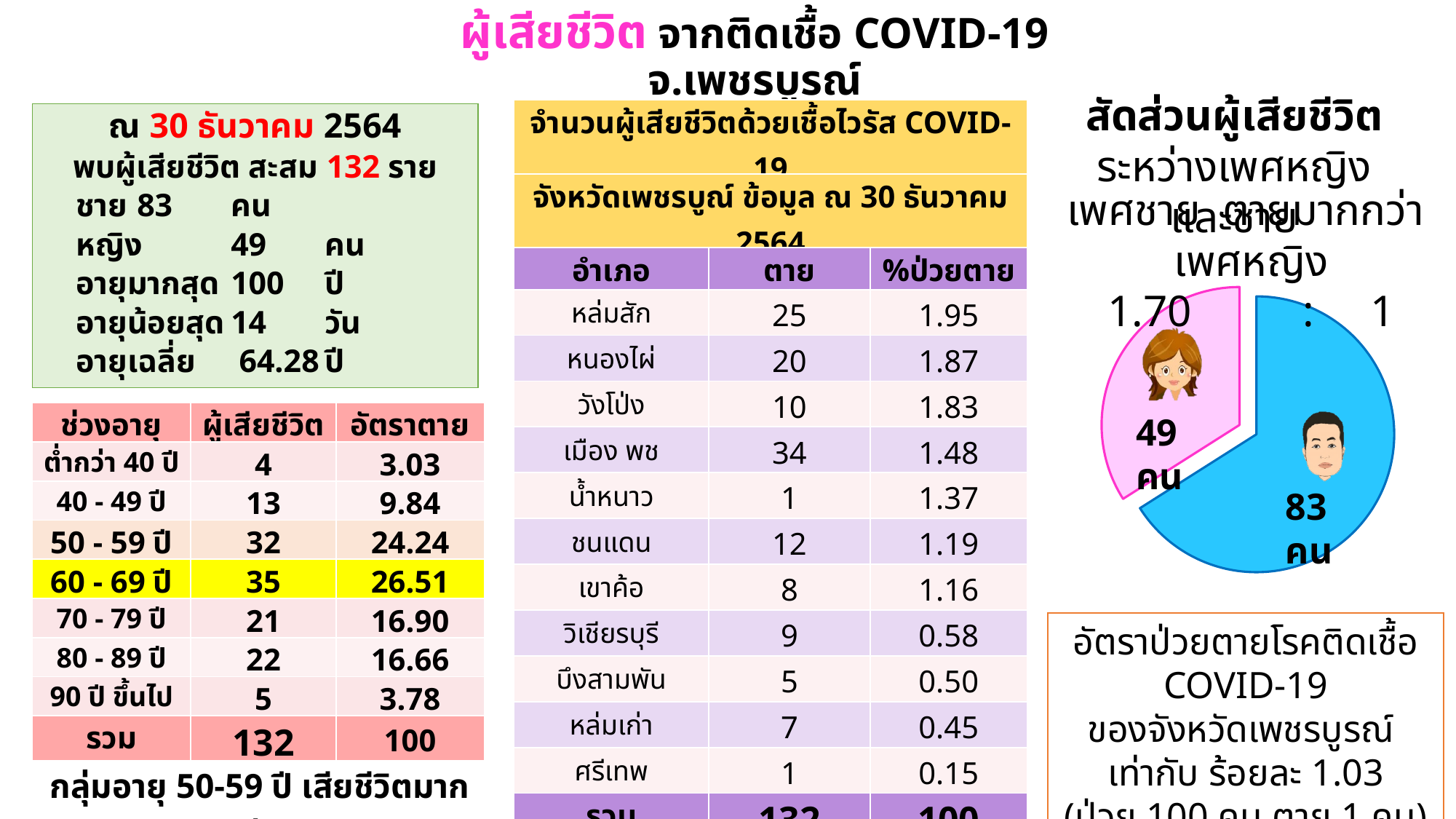
What kind of chart is shown on the right side of the slide? pie chart How many slices does the pie chart on the right have? 2 In the pie chart, what is the value shown for the female (เพศหญิง) slice? 49 คน Which slice of the pie chart is the largest? male (83 คน) In the pie chart, how many more deaths are there among males than females? 34 What colour is the male slice in the pie chart? blue In the pie chart, what is the value shown for the male (เพศชาย) slice? 83 คน What is the total number of deaths represented by the two slices of the pie chart? 132 Which slice of the pie chart is the smallest? female (49 คน) In the pie chart, is the male slice larger or smaller than the female slice? larger What colour is the female slice in the pie chart? pink